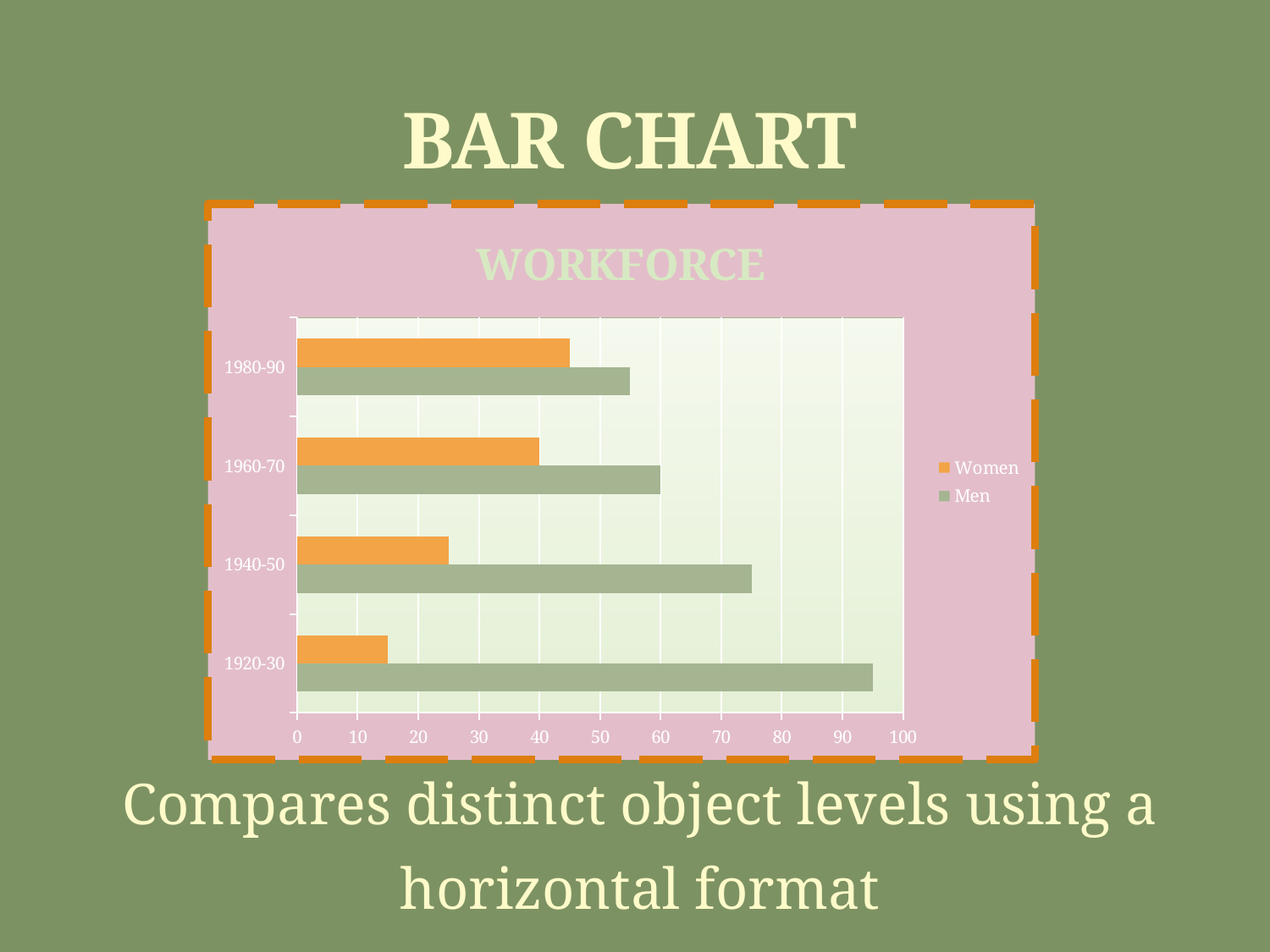
For 1940-50, which is larger, the value for Men or the value for Women? Men What is the title of the chart? WORKFORCE Is the value for Men in 1920-30 greater or less than 90? greater Is the value for Women in 1920-30 greater or less than 20? less In which period is the value for Women lowest? 1920-30 Do the values for Women rise or fall from 1920-30 to 1980-90? rise What kind of chart is shown on the slide? bar chart What is the value for Women in 1960-70? 40 In which period is the value for Women highest? 1980-90 In which period is the value for Men highest? 1920-30 How many time-period categories are plotted in the WORKFORCE chart? 4 How many series does the legend of the WORKFORCE chart list? 2